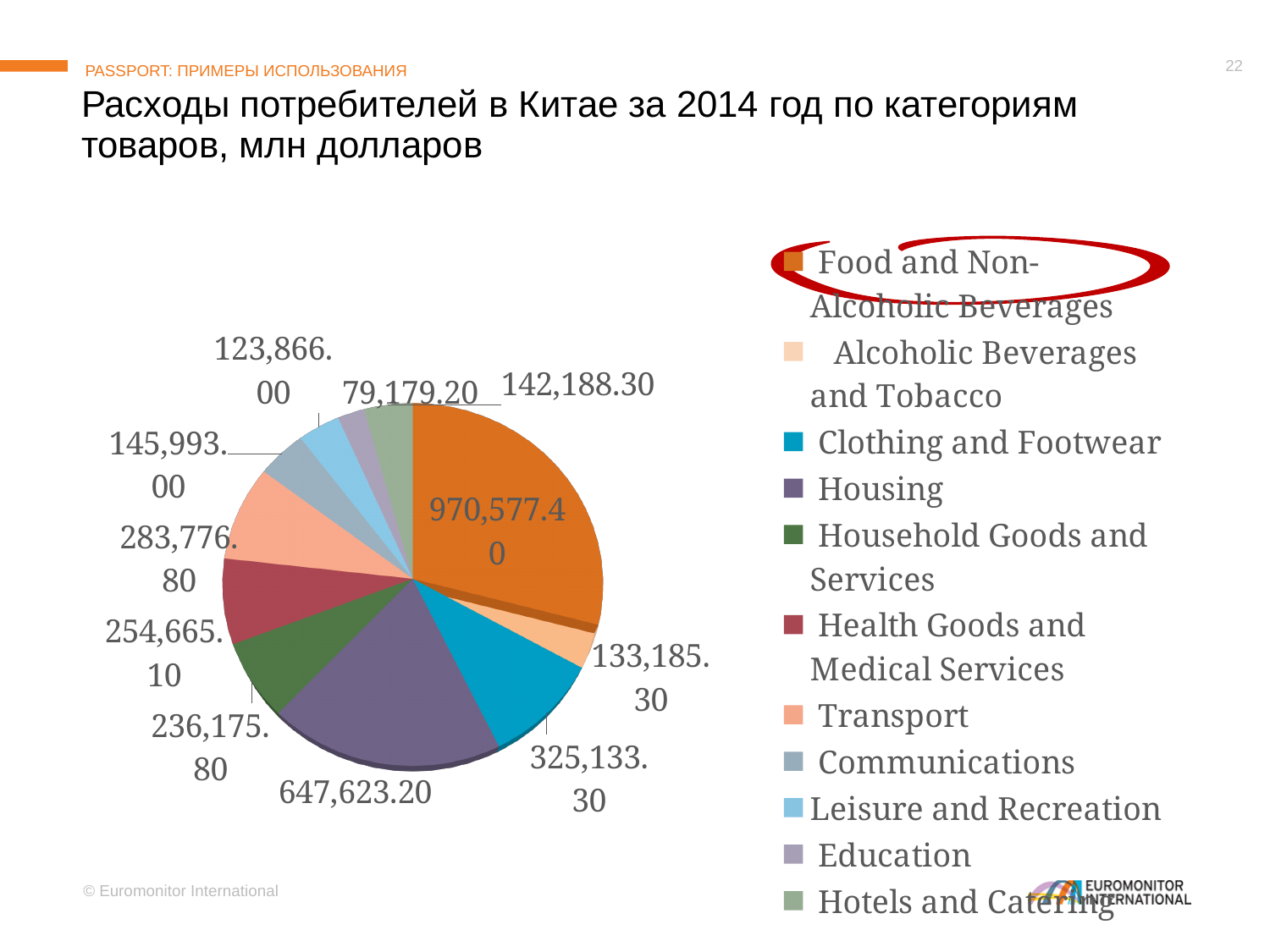
What is the value shown for Housing? 647,623.20 How many categories does the legend of the pie chart list? 11 Which category has the largest slice of the pie? Food and Non-Alcoholic Beverages What is the value shown for Food and Non-Alcoholic Beverages? 970,577.40 What is the value shown for Education? 79,179.20 What type of chart is shown on the slide? Pie chart What is the value shown for Clothing and Footwear? 325,133.30 Which category has the smallest slice of the pie? Education What is the value shown for Transport? 283,776.80 Which is larger, the value for Clothing and Footwear or the value for Transport? Clothing and Footwear Which legend entry is circled in red on the slide? Food and Non-Alcoholic Beverages What is the difference between the values for Food and Non-Alcoholic Beverages and Housing? 322,954.20